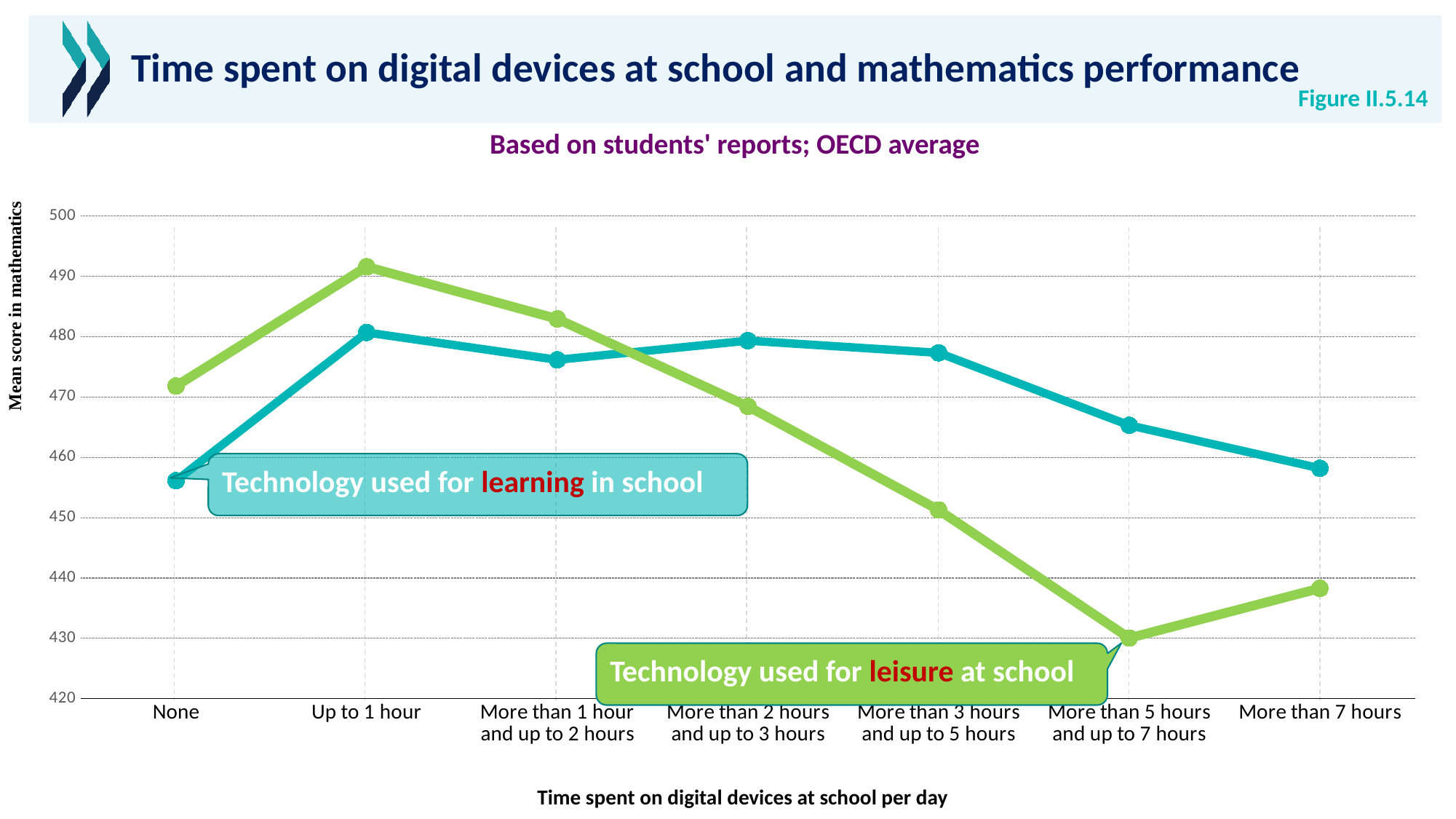
At the 'None' category, which series has the higher mean score in mathematics? Technology used for leisure at school Does the 'Technology used for leisure at school' series rise or fall from 'Up to 1 hour' to 'More than 5 hours and up to 7 hours'? Fall What kind of chart is shown on the slide? Line chart Is the value for 'Technology used for leisure at school' at 'More than 5 hours and up to 7 hours' greater or less than 440? less Is the value for 'Technology used for learning in school' at 'Up to 1 hour' greater or less than 470? greater How many time-spent categories are shown along the x axis? 7 For the 'Technology used for leisure at school' series, which category has the highest mean score in mathematics? Up to 1 hour Is the value for 'Technology used for leisure at school' at 'None' greater or less than 460? greater At the 'More than 7 hours' category, which series has the higher mean score in mathematics? Technology used for learning in school How many data series are plotted on the chart? 2 For the 'Technology used for leisure at school' series, which category has the lowest mean score in mathematics? More than 5 hours and up to 7 hours